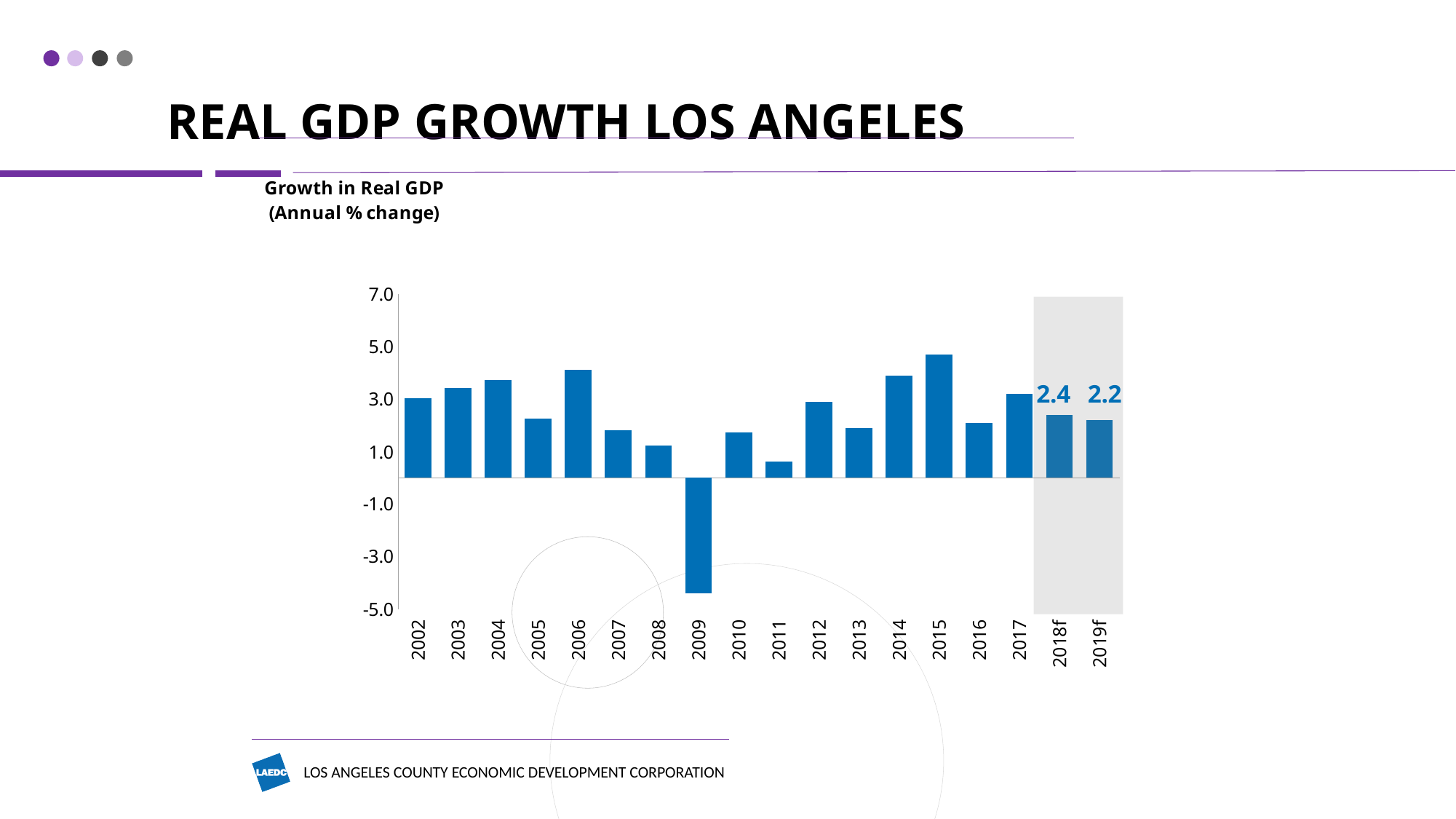
Which year has the lowest real GDP growth? 2009 What is the value for 2019f? 2.2 What is the value for 2018f? 2.4 Which year has the highest real GDP growth? 2015 Is the value for 2011 greater or less than 1.0? less Is the value for 2009 greater or less than -3.0? less How many years are shown on the x axis? 18 What is the difference between the values for 2018f and 2019f? 0.2 What kind of chart is shown on the slide? Bar chart What is the title of the chart? Growth in Real GDP (Annual % change) Which is larger, the value for 2014 or the value for 2016? 2014 Is the value for 2006 greater or less than 3.0? greater